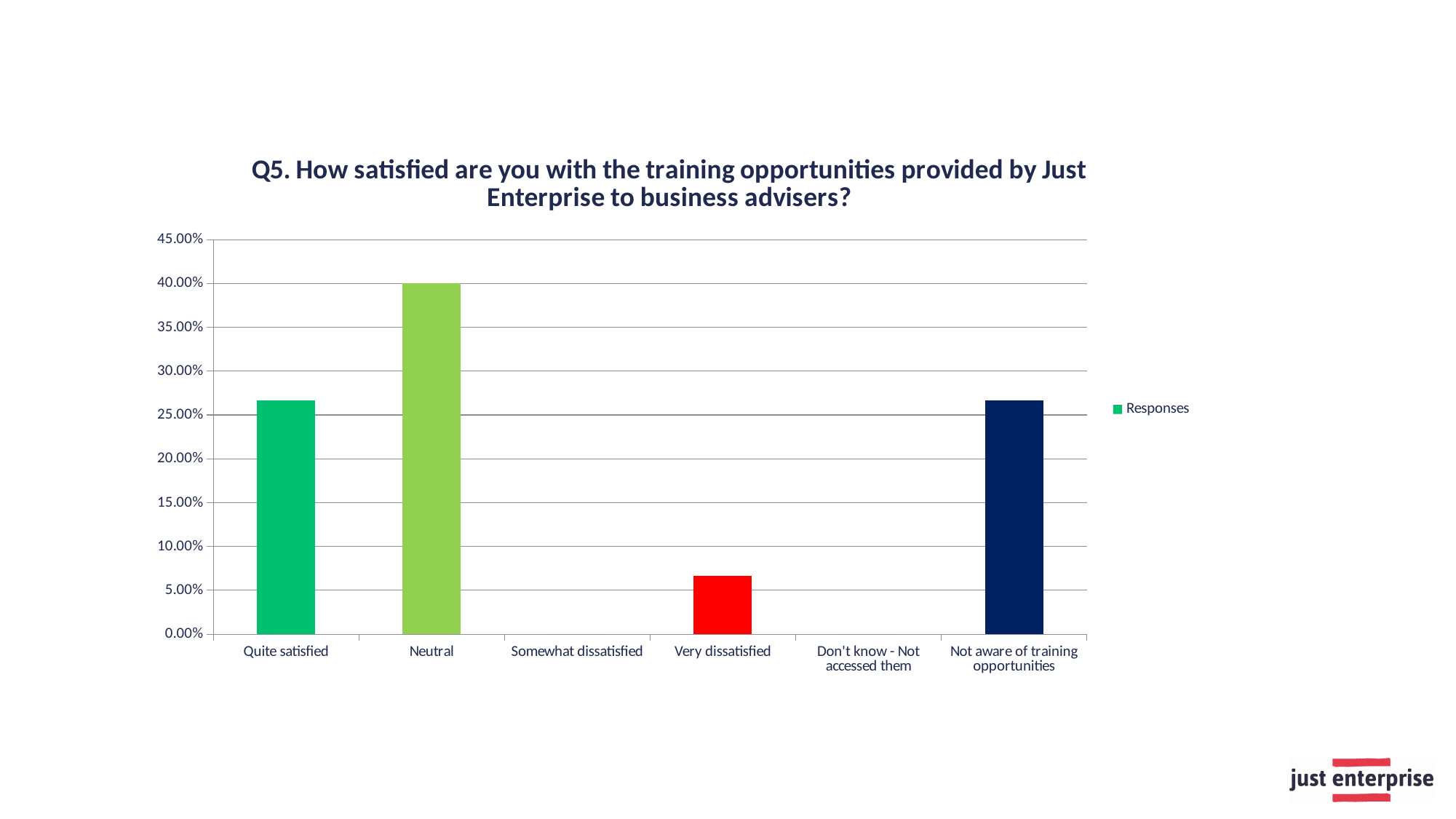
How many categories are shown on the x axis? 6 Which category has the highest value? Neutral What type of chart is shown on the slide? Bar chart What is the value for Neutral? 40.00% What is the name of the series shown in the legend? Responses Is the value for Very dissatisfied greater or less than 10.00%? less What is the title of the chart? Q5. How satisfied are you with the training opportunities provided by Just Enterprise to business advisers? How many series does the legend list? 1 Which is larger, the value for Quite satisfied or the value for Very dissatisfied? Quite satisfied Which is larger, the value for Neutral or the value for Very dissatisfied? Neutral Is the value for Quite satisfied greater or less than 25.00%? greater Is the value for Not aware of training opportunities greater or less than 30.00%? less